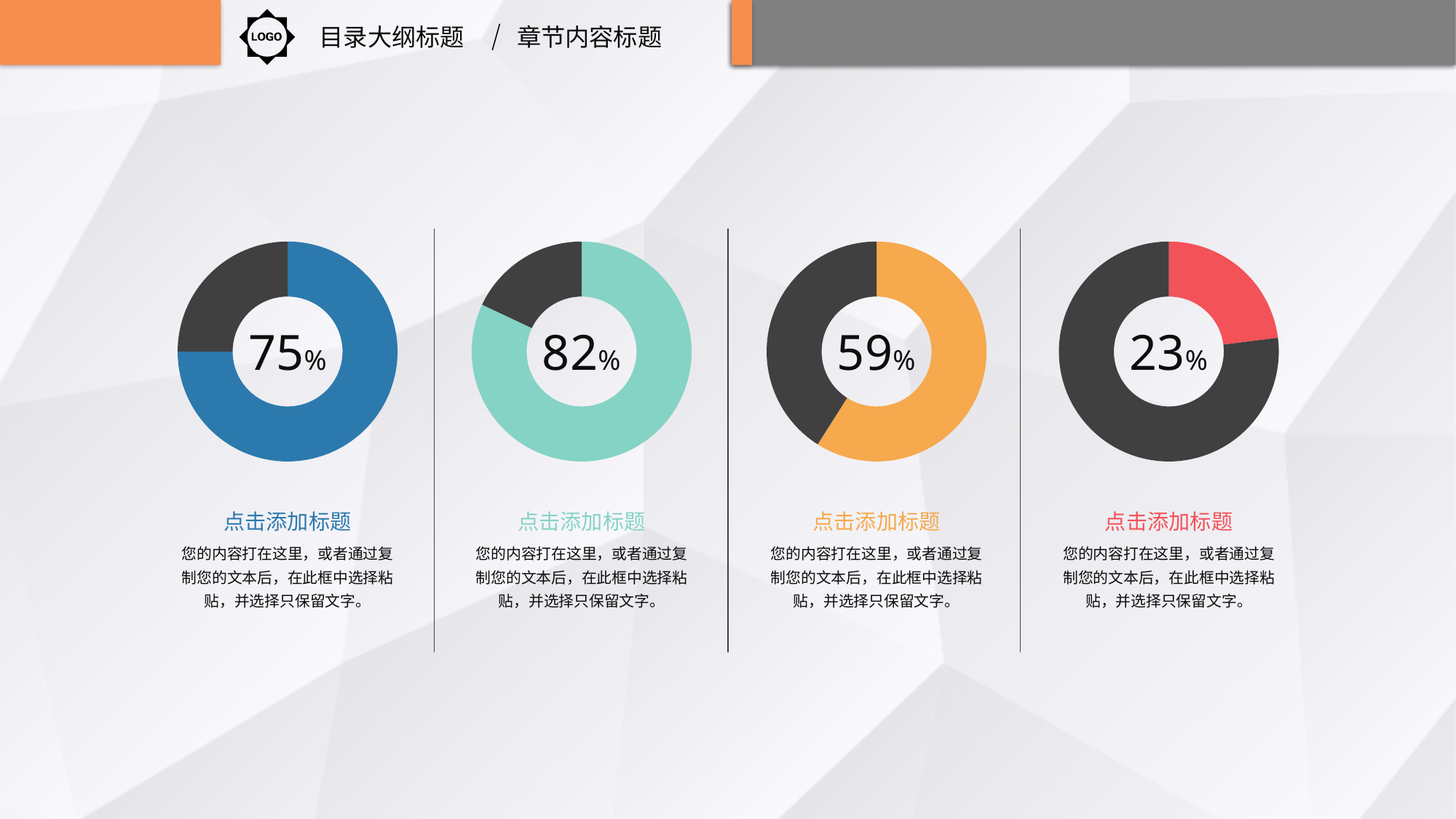
What colour is the filled portion of the rightmost donut chart? Red What value is shown in the centre of the third donut chart from the left? 59% What value is shown in the centre of the rightmost donut chart? 23% Which is larger, the percentage in the leftmost donut chart or the percentage in the third donut chart from the left? The leftmost (75%) What value is shown in the centre of the second donut chart from the left? 82% How many donut charts are on the slide? 4 Which of the four donut charts shows the highest percentage? The second from the left (82%) Which of the four donut charts shows the lowest percentage? The rightmost (23%) What colour is the filled portion of the leftmost donut chart? Blue What is the difference between the percentage in the second donut chart (82%) and the percentage in the rightmost donut chart (23%)? 59% What kind of chart is used for each of the four percentages on the slide? Donut chart What value is shown in the centre of the leftmost donut chart? 75%